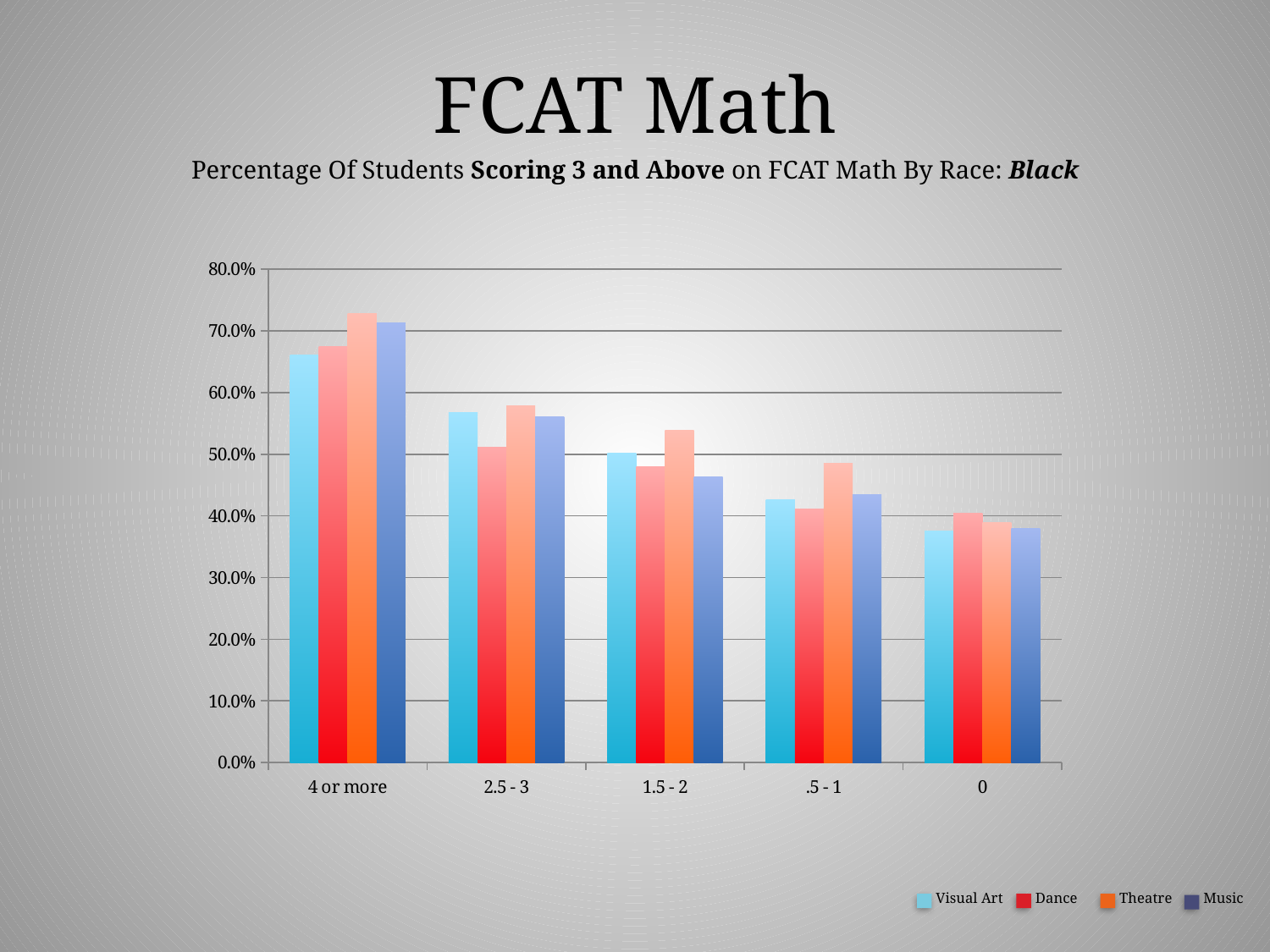
Do the Theatre values rise or fall moving along the x axis from "4 or more" to "0"? fall Is the Dance value for the "2.5 - 3" category greater or less than 60.0%? less How many series does the legend list? 4 Which series is shown in orange in the legend? Theatre What kind of chart is shown on the slide? bar chart Is the Visual Art value for the "0" category greater or less than 40.0%? less In the "1.5 - 2" category, which is larger: Theatre or Music? Theatre Is the Music value for the ".5 - 1" category greater or less than 40.0%? greater How many categories are shown along the x axis? 5 In which category is the Theatre bar the highest? 4 or more In which category is the Visual Art bar the lowest? 0